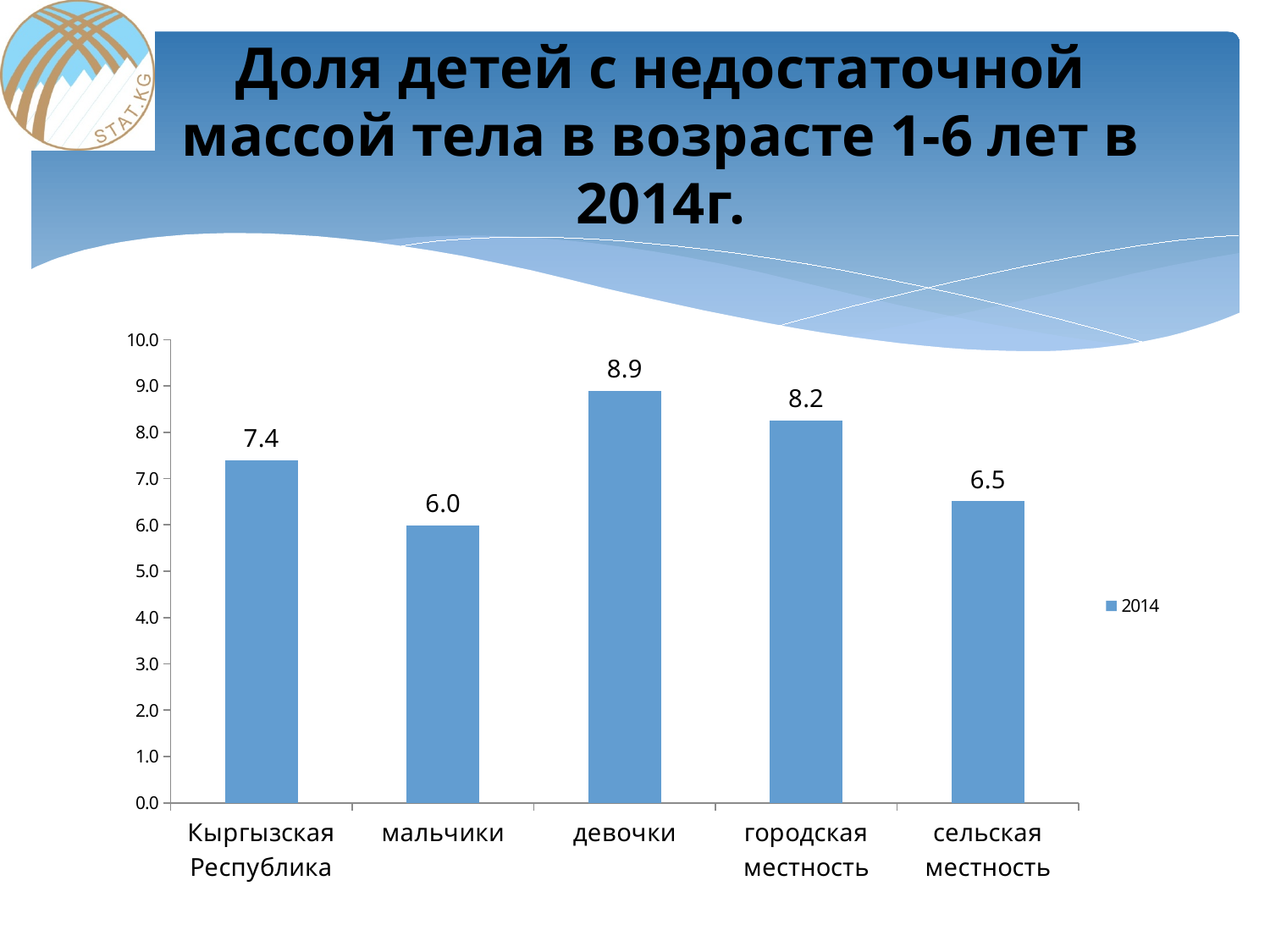
What is the difference between the values for городская местность and сельская местность? 1.7 How many categories are shown on the x axis? 5 What kind of chart is shown on the slide? bar chart What is the value for сельская местность? 6.5 Which category has the highest value? девочки What is the value for девочки? 8.9 What is the value for мальчики? 6.0 Which is larger, the value for городская местность or the value for сельская местность? городская местность What is the difference between the values for девочки and мальчики? 2.9 Which category has the lowest value? мальчики What is the value for Кыргызская Республика? 7.4 How many series does the legend list? 1